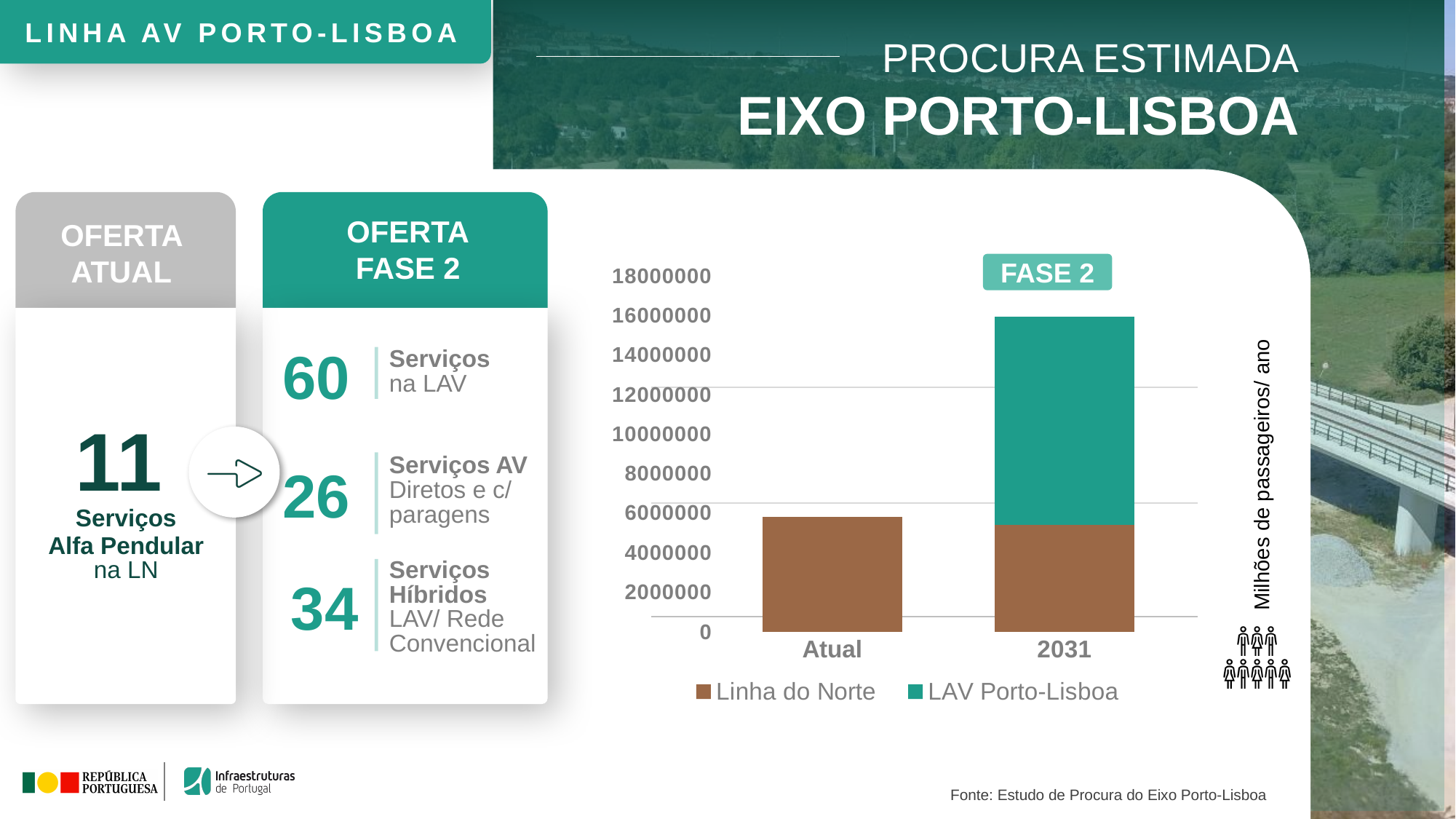
Is the value for Atual greater or less than 4000000? greater Which series are listed in the chart legend? Linha do Norte and LAV Porto-Lisboa Is the total value of the 2031 bar greater or less than 14000000? greater What is the label on the vertical axis of the chart? Milhões de passageiros/ ano Do the total values rise or fall from Atual to 2031? rise In the 2031 bar, which series accounts for the larger segment, Linha do Norte or LAV Porto-Lisboa? LAV Porto-Lisboa What kind of chart is shown on the slide? Stacked bar chart Is the total value of the 2031 bar greater or less than 18000000? less Which category has the lowest total bar? Atual Which category has the taller total bar, Atual or 2031? 2031 How many categories are shown on the x axis of the chart? 2 How many series does the chart legend list? 2